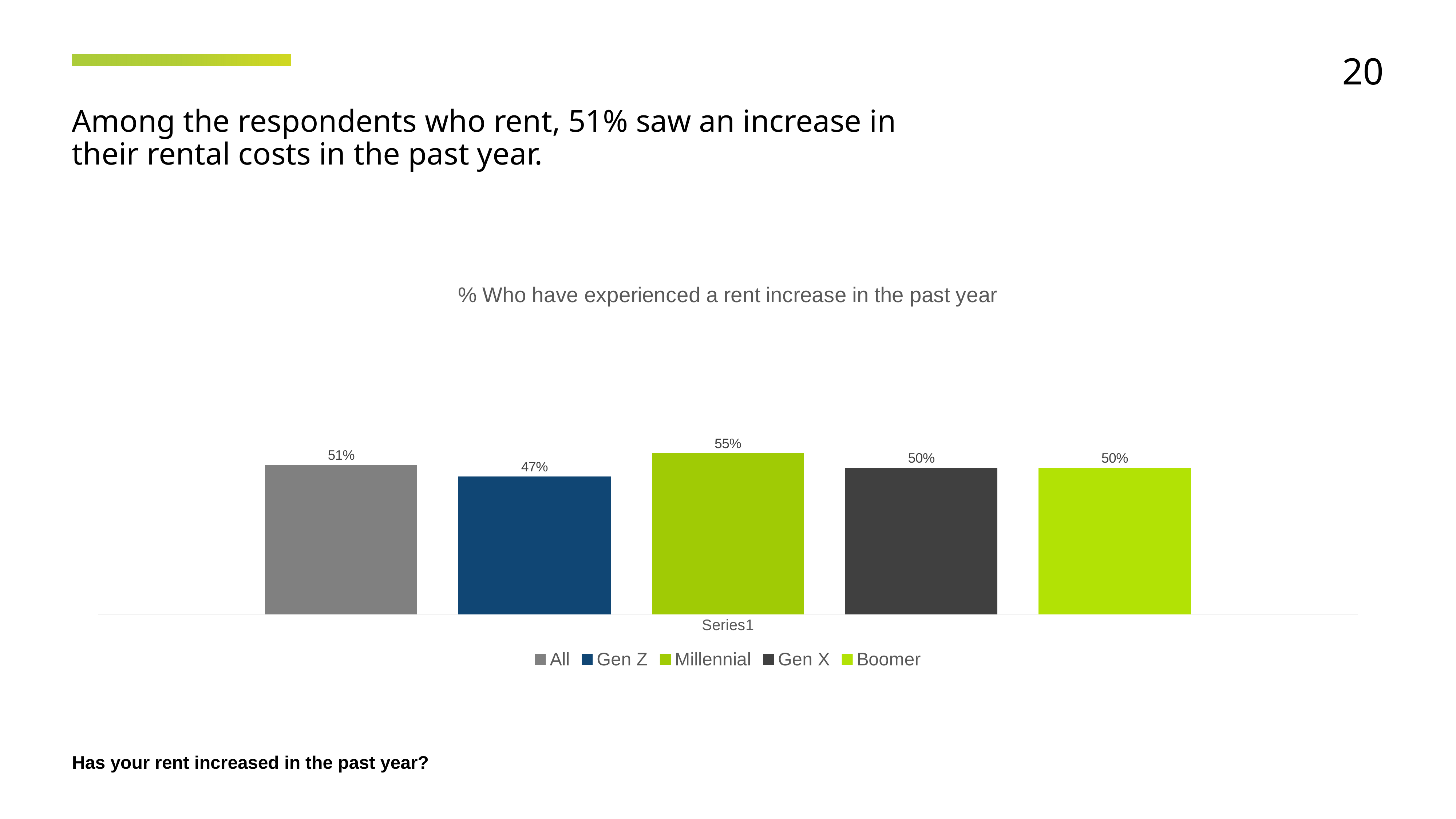
Which is larger, the value for Millennial or the value for Gen X? Millennial Which group has the highest percentage who experienced a rent increase? Millennial What is the value shown for Millennial in the chart? 55% Which group has the lowest percentage who experienced a rent increase? Gen Z What percentage of Gen Z respondents experienced a rent increase in the past year? 47% How many series does the legend list? 5 What is the difference between the Millennial value and the Gen Z value? 8% What is the value shown for Gen X in the chart? 50% What is the title of the chart? % Who have experienced a rent increase in the past year What is the value shown for All respondents in the chart? 51% What is the difference between the All value and the Boomer value? 1% What kind of chart is shown on the slide? Bar chart